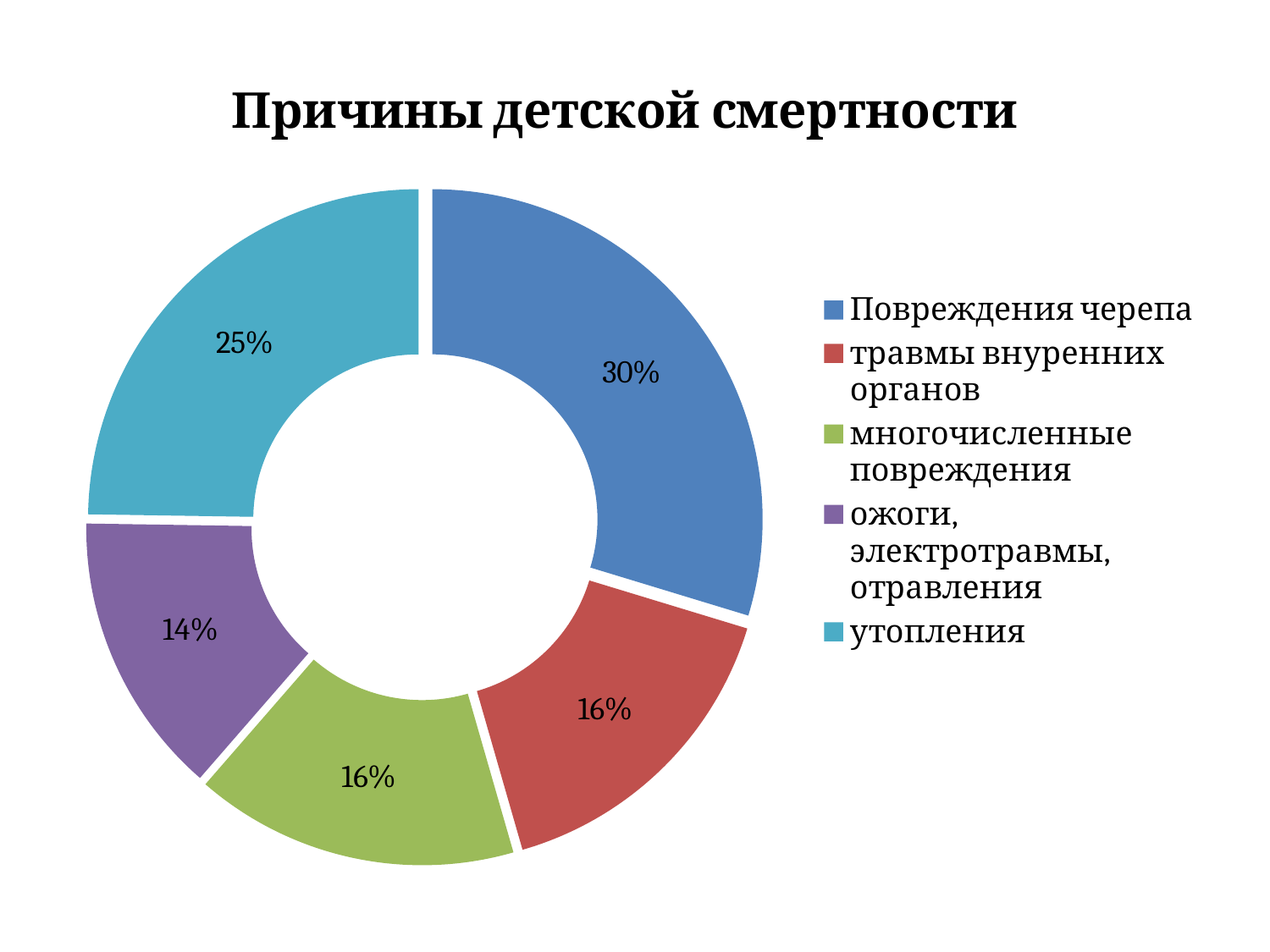
Which is larger: the share of "утопления" or the share of "многочисленные повреждения"? утопления What share does "ожоги, электротравмы, отравления" have? 14% How many categories does the chart show? 5 Which category has the largest share? Повреждения черепа What is the title of the chart? Причины детской смертности What kind of chart is shown on the slide? Doughnut (pie) chart What share does "травмы внуренних органов" have? 16% What is the difference between the shares of "Повреждения черепа" and "утопления"? 5% What share does "Повреждения черепа" have? 30% Which category has the smallest share? ожоги, электротравмы, отравления Which colour represents "утопления" in the chart? Light blue (cyan) What share does "утопления" have? 25%